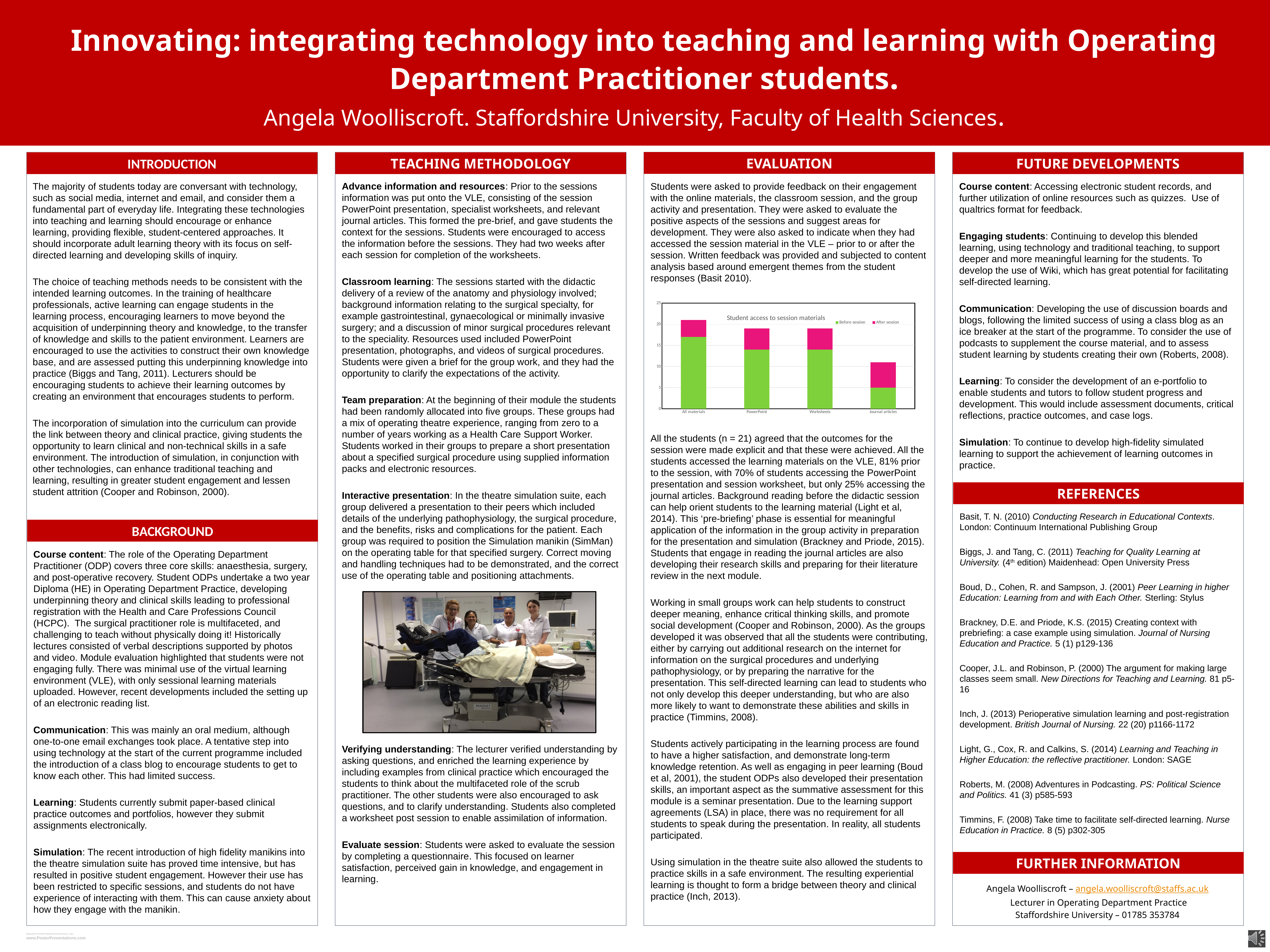
Is the total bar for All materials greater or less than 20? greater Is the total bar for Journal articles greater or less than 15? less How many categories are shown on the x axis of the chart? 4 Is the Before session value for Journal articles greater or less than 10? less How many series does the legend of the chart list? 2 What are the two series named in the chart legend? Before session, After session Which category has the lowest total bar in the chart? Journal articles What is the title of the chart in the Evaluation section? Student access to session materials Which is larger, the total bar for PowerPoint or the total bar for Journal articles? PowerPoint Which category has the highest total bar in the chart? All materials What kind of chart is shown in the Evaluation section? bar chart